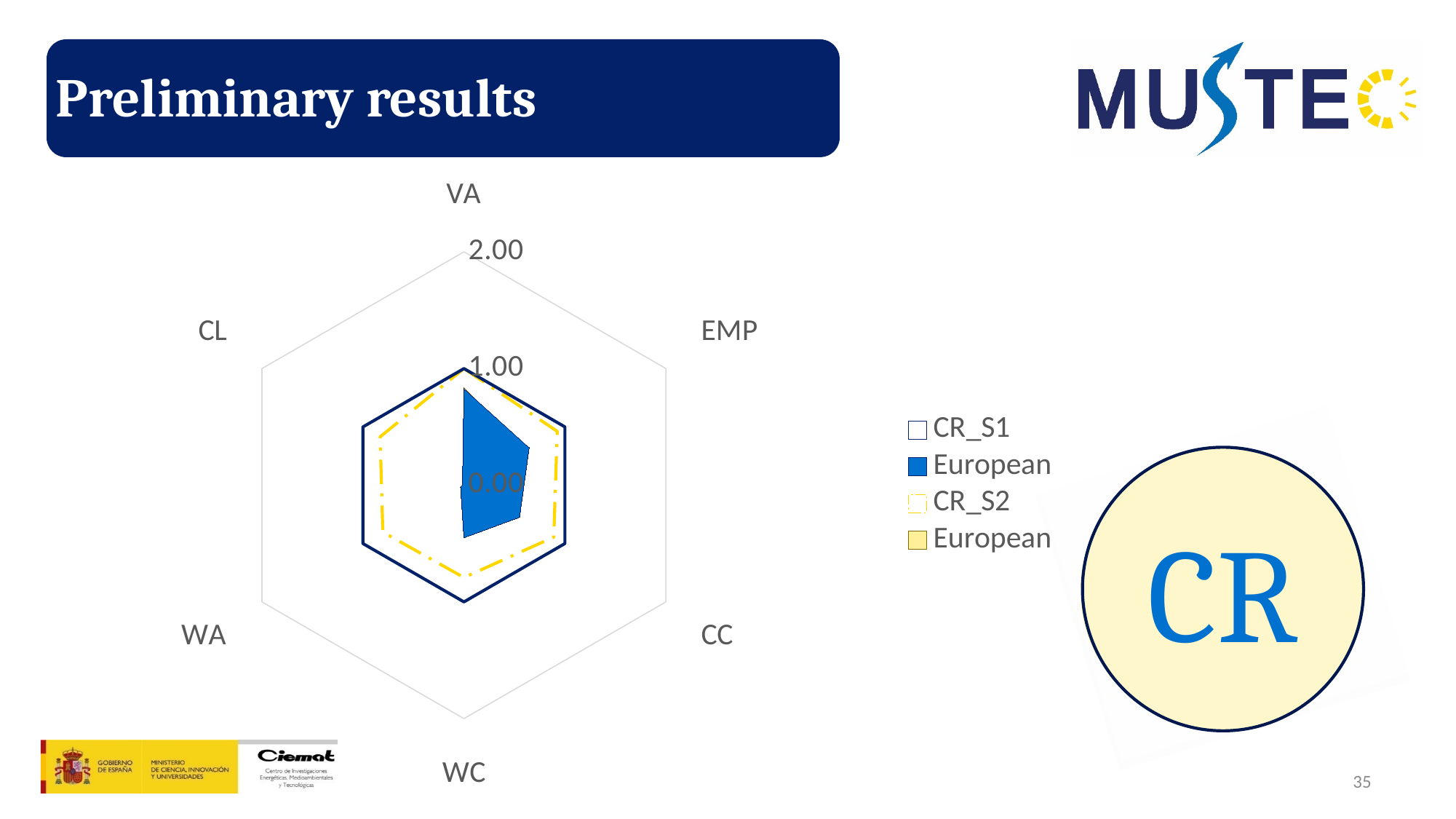
What is the value of the CR_S1 series on the VA axis? 1.00 Is the value of the CR_S2 series on the CL axis greater or less than 2.00? less Is the value of the blue European series on the CC axis greater or less than 1.00? less Is the value of the blue European series on the EMP axis greater or less than 1.00? less Which series is drawn as a solid dark blue outline in the radar chart? CR_S1 What is the value of the CR_S1 series on the WC axis? 1.00 What is the title of the slide containing the radar chart? Preliminary results How many axes (categories) does the radar chart have? 6 What kind of chart is shown on the slide? radar chart How many series does the legend of the radar chart list? 4 What is the highest tick value shown on the radar chart's axis? 2.00